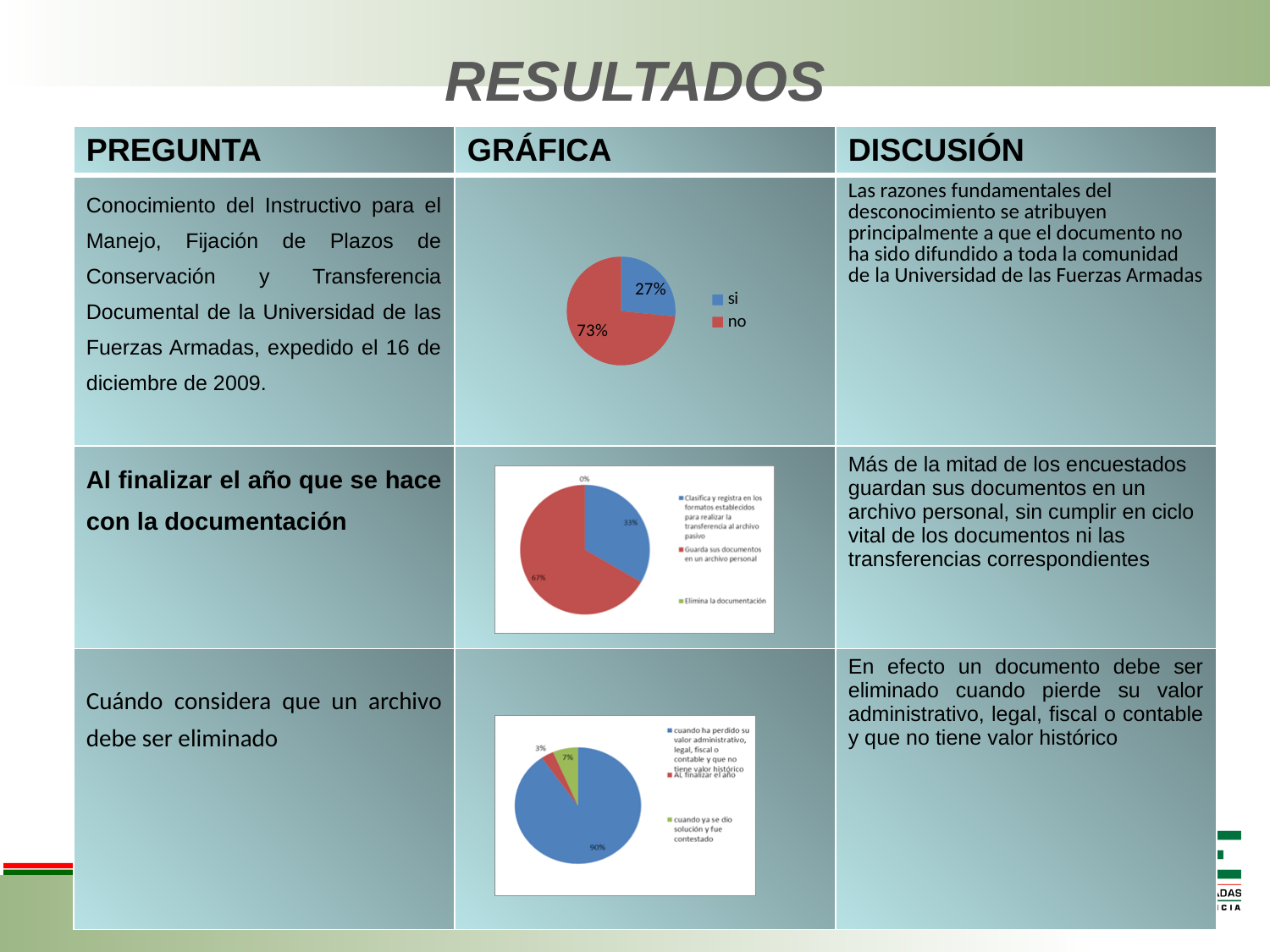
In the top chart (Conocimiento del Instructivo), what percentage is shown for "si"? 27% How many categories does the legend of the bottom chart (Cuándo considera que un archivo debe ser eliminado) list? 3 In the top chart (Conocimiento del Instructivo), what is the difference in percentage points between "no" and "si"? 46 What type of chart is used for the question "Al finalizar el año que se hace con la documentación"? Pie chart In the bottom chart (Cuándo considera que un archivo debe ser eliminado), which category has the largest share? cuando ha perdido su valor administrativo, legal, fiscal o contable y que no tiene valor histórico How many entries does the legend of the top chart (Conocimiento del Instructivo) list? 2 In the bottom chart (Cuándo considera que un archivo debe ser eliminado), what percentage corresponds to "cuando ha perdido su valor administrativo, legal, fiscal o contable y que no tiene valor histórico"? 90% In the top chart (Conocimiento del Instructivo), which category has the larger share, "si" or "no"? no In the middle chart (Al finalizar el año que se hace con la documentación), what percentage corresponds to "Guarda sus documentos en un archivo personal"? 67% In the middle chart (Al finalizar el año que se hace con la documentación), which category has the largest share? Guarda sus documentos en un archivo personal In the middle chart (Al finalizar el año que se hace con la documentación), what percentage corresponds to "Elimina la documentación"? 0% In the top chart (Conocimiento del Instructivo), what percentage is shown for "no"? 73%